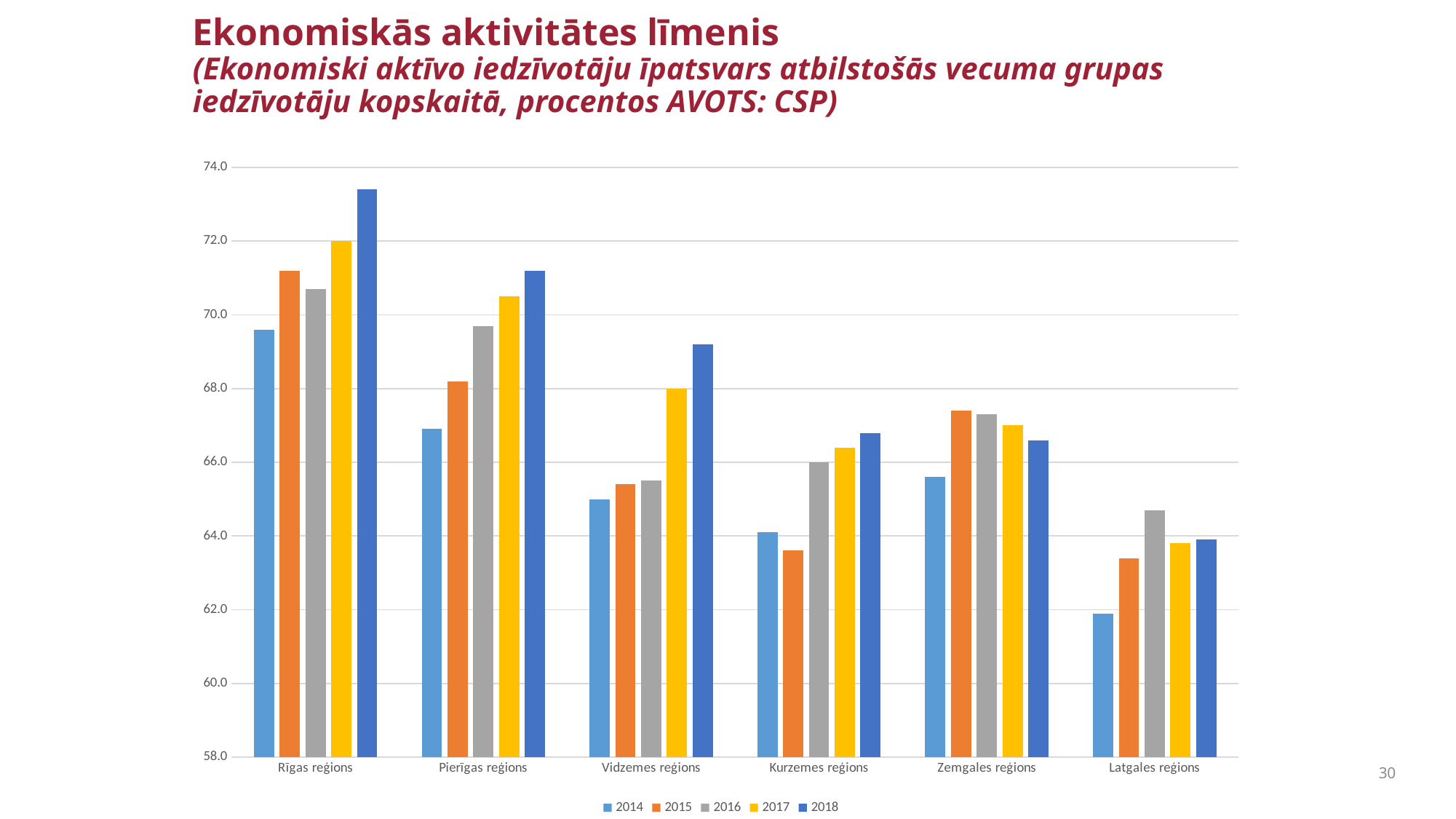
Which years are listed in the legend? 2014, 2015, 2016, 2017, 2018 For Zemgales reģions, which is larger: the value for 2015 or the value for 2018? 2015 Which region has the highest value for 2018? Rīgas reģions Is the value for Rīgas reģions in 2018 greater or less than 72.0? greater Do the values for Rīgas reģions rise or fall from 2014 to 2018? rise Which region has the lowest value for 2014? Latgales reģions Is the value for Kurzemes reģions in 2015 greater or less than 64.0? less What kind of chart is shown on the slide? bar chart How many regions are shown on the x axis of the chart? 6 How many series does the legend list? 5 Is the value for Pierīgas reģions in 2014 greater or less than 66.0? greater